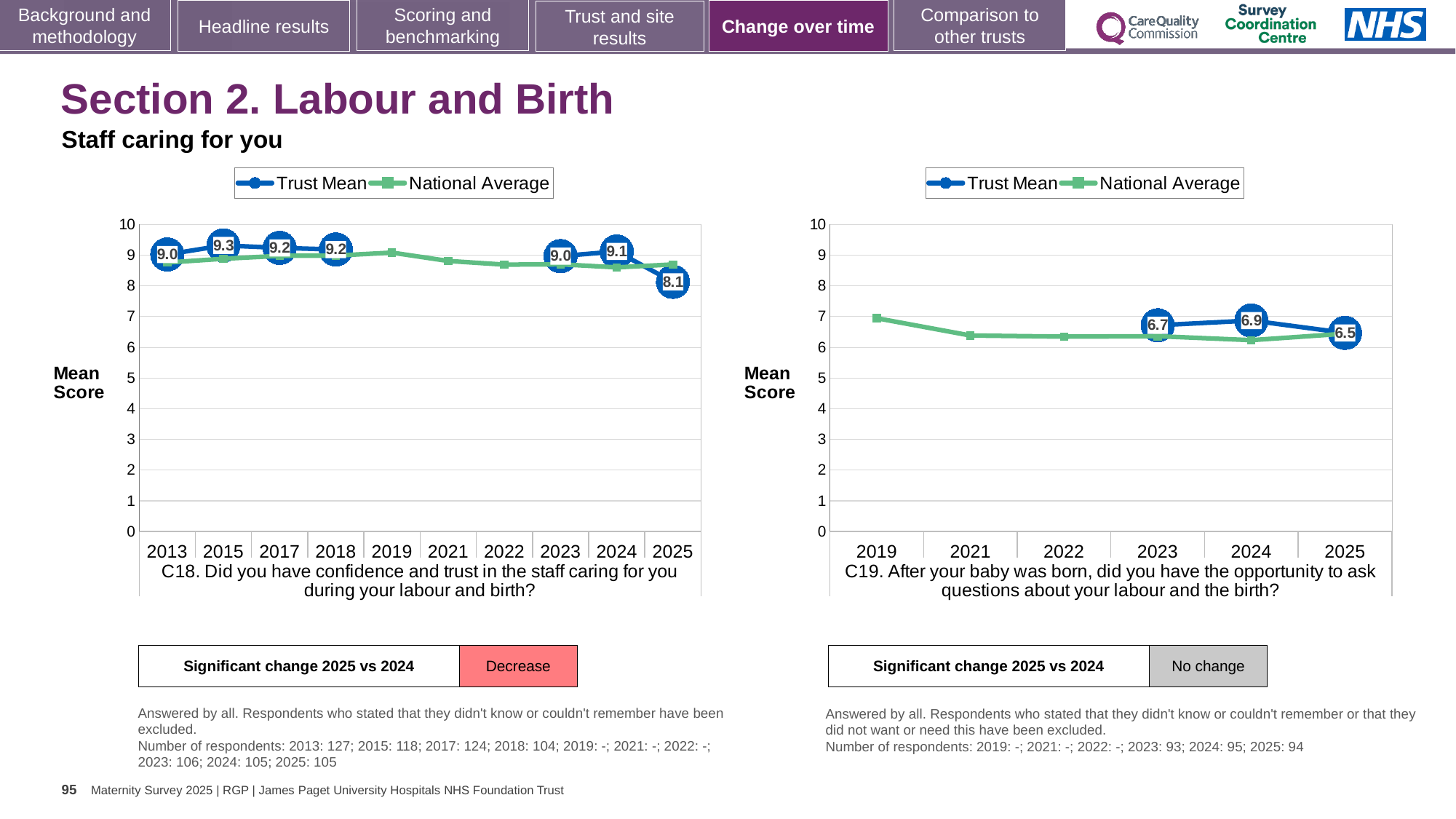
In the C18 chart on the left, what is the Trust Mean for 2025? 8.1 How many series does the legend of the C19 chart on the right list? 2 In the C18 chart on the left, which year has the lowest Trust Mean? 2025 In the C18 chart on the left, how many years are shown on the x axis? 10 In the C19 chart on the right, what is the Trust Mean for 2024? 6.9 In the C18 chart on the left, what is the difference between the Trust Mean for 2024 and 2025? 1.0 In the C18 chart on the left, what is the Trust Mean for 2015? 9.3 In the C19 chart on the right, is the National Average for 2019 greater or less than 6? greater In the C19 chart on the right, is the Trust Mean for 2025 larger or smaller than the Trust Mean for 2023? smaller In the C18 chart on the left, which year has the highest Trust Mean? 2015 In the C19 chart on the right, which year has the highest Trust Mean? 2024 What kind of chart is the C18 chart on the left? line chart